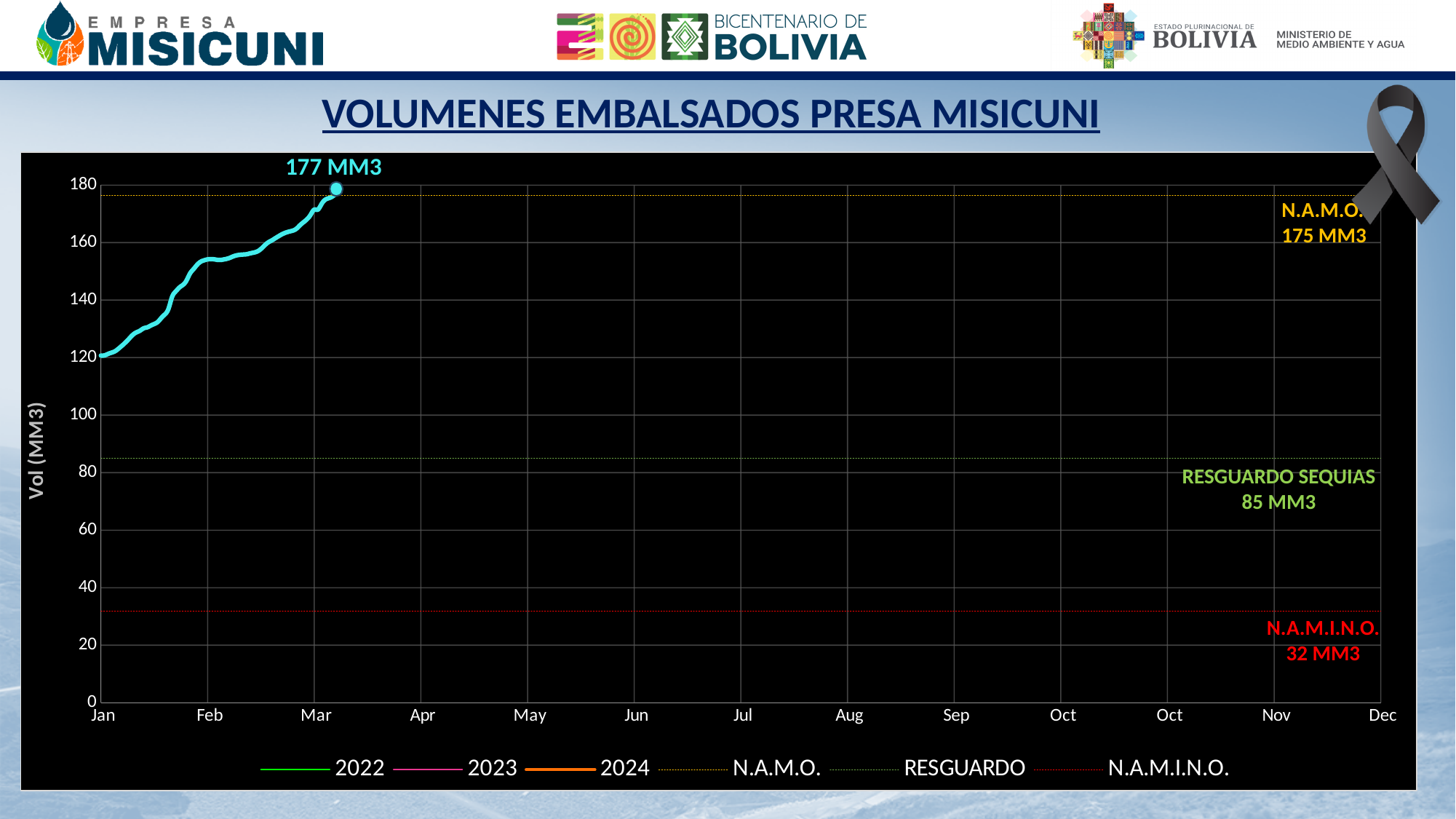
What is the label on the vertical axis? Vol (MM3) What is the latest labelled volume on the plotted line? 177 MM3 What volume is given for the N.A.M.I.N.O. reference level? 32 MM3 Which is larger, the labelled volume on the line (177 MM3) or the N.A.M.O. level (175 MM3)? 177 MM3 Is the plotted volume at Jan greater or less than 140? less What is the difference between the N.A.M.O. level and the RESGUARDO SEQUIAS level? 90 MM3 What kind of chart is shown on the slide? line chart How many entries does the legend list? 6 What volume is given for the RESGUARDO SEQUIAS reference level? 85 MM3 What volume is given for the N.A.M.O. reference level? 175 MM3 Does the plotted volume rise or fall from Jan to Mar? rise By how much does the labelled value of 177 MM3 exceed the N.A.M.O. level of 175 MM3? 2 MM3